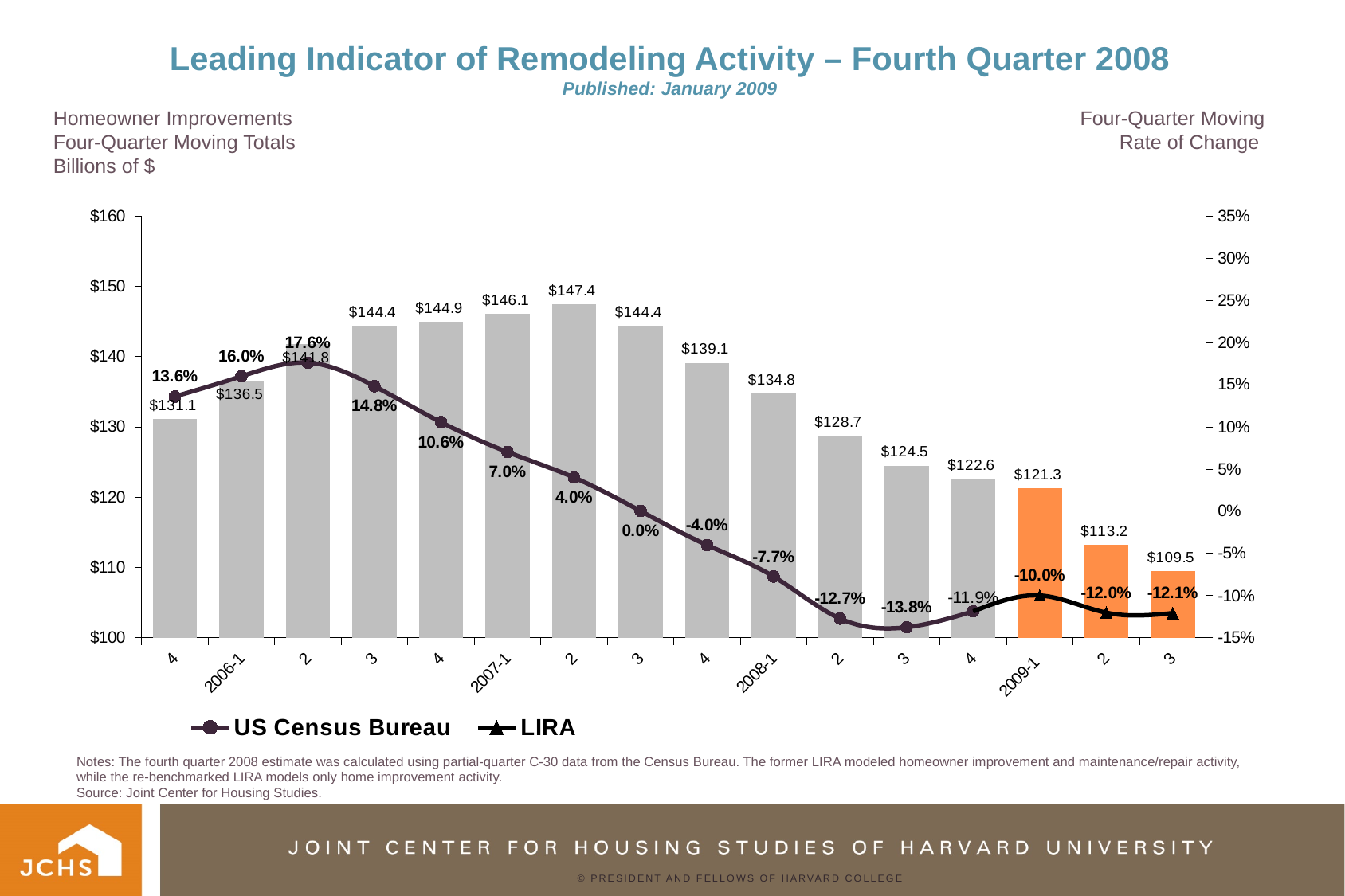
What is the highest four-quarter moving rate of change shown on the line? 17.6% Which quarter has the highest four-quarter moving total bar? 2007 Q2 ($147.4) What kind of chart is this? Combination bar and line chart How many series does the legend list? 2 What is the LIRA rate of change value for 2009-1? -10.0% What is the four-quarter moving rate of change for 2008-1? -7.7% What is the four-quarter moving total shown for 2009-1? $121.3 How many bars are plotted on the chart? 16 Which quarter has the lowest four-quarter moving total bar? 2009 Q3 ($109.5) What is the four-quarter moving total for homeowner improvements in 2007-1? $146.1 Which is larger, the moving total for 2006-1 or for 2008-1? 2006-1 What is the difference between the moving totals for 2009-1 and the following quarter (2009 Q2)? $8.1